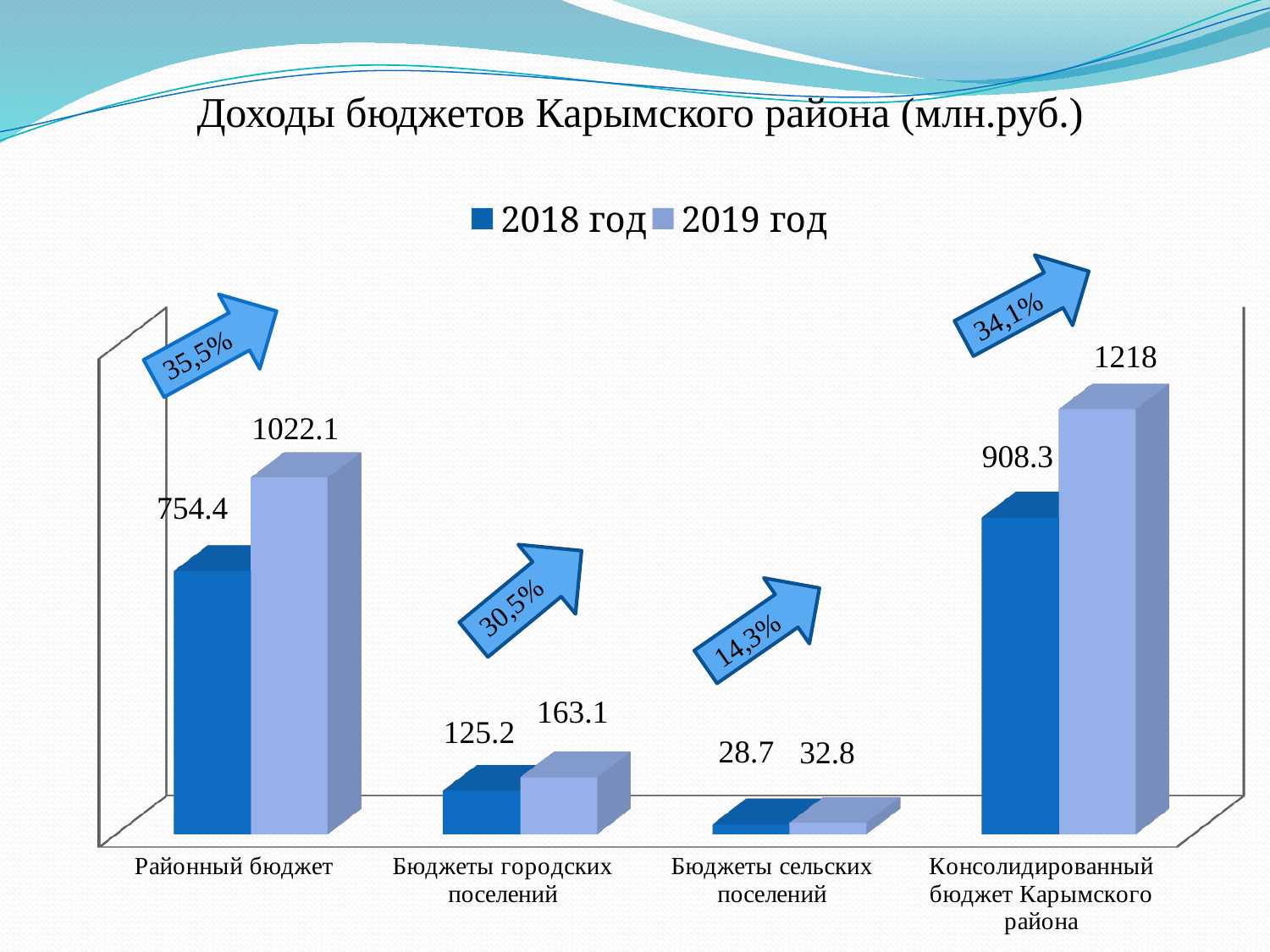
What is the value for Бюджеты городских поселений in 2019 год? 163.1 How many categories are shown on the x axis? 4 What is the value for Консолидированный бюджет Карымского района in 2019 год? 1218 What is the difference between the 2019 год and 2018 год values for Бюджеты городских поселений? 37.9 What is the value for Бюджеты сельских поселений in 2018 год? 28.7 Which category has the lowest value in 2018 год? Бюджеты сельских поселений What is the value for Районный бюджет in 2018 год? 754.4 How many series does the legend list? 2 Which is larger for Консолидированный бюджет Карымского района: the 2018 год value or the 2019 год value? 2019 год Which category has the highest value in 2019 год? Консолидированный бюджет Карымского района What is the difference between the 2019 год and 2018 год values for Районный бюджет? 267.7 What kind of chart is shown on the slide? Bar chart